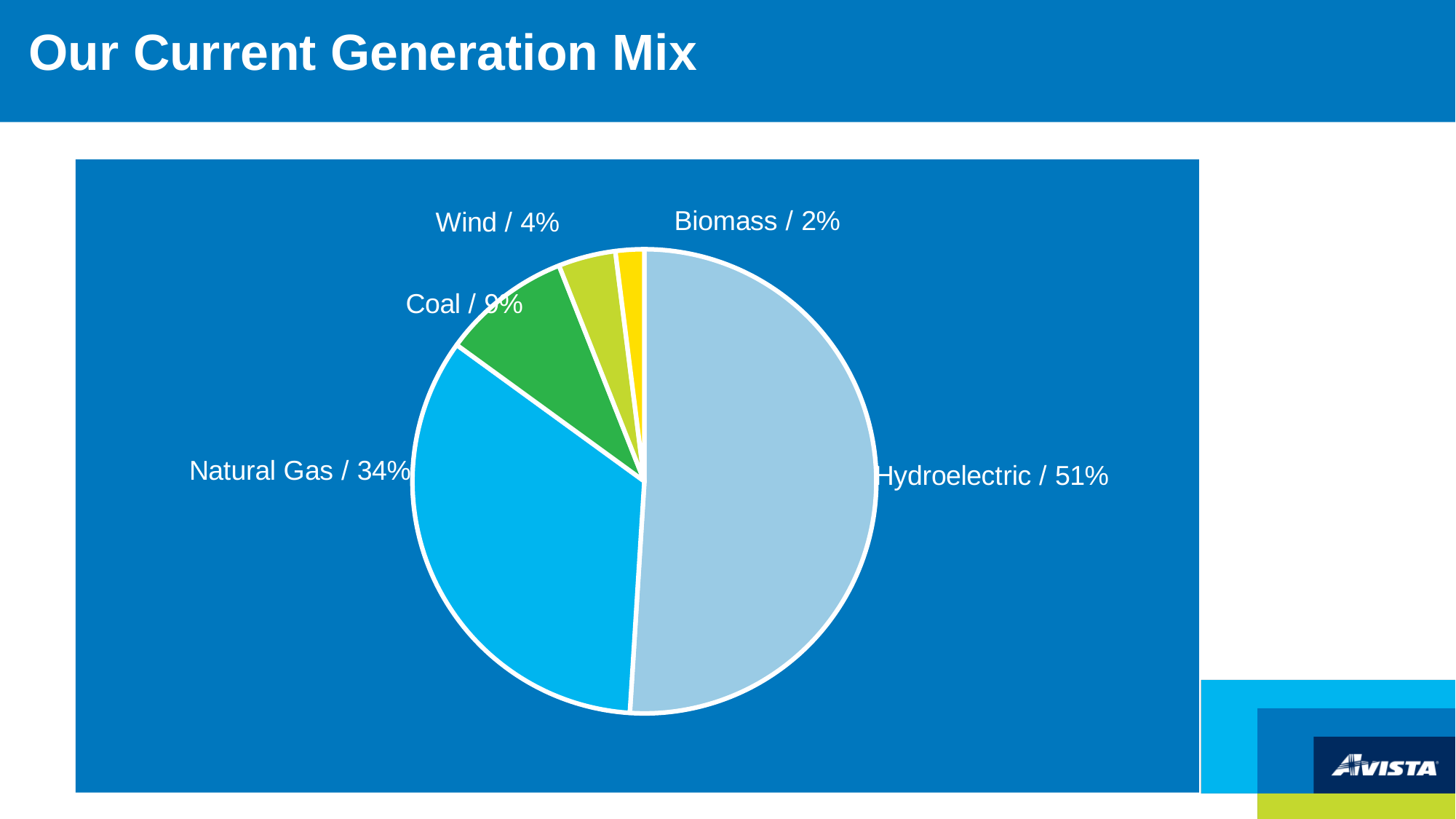
How many sources are shown in the pie chart? 5 What share of the generation mix is Wind? 4% What share of the generation mix is Hydroelectric? 51% Which source has the largest share of the generation mix? Hydroelectric Which source has the smallest share of the generation mix? Biomass What kind of chart is shown on the slide? Pie chart What share of the generation mix is Coal? 9% What is the title of the slide containing the chart? Our Current Generation Mix Which has a larger share, Coal or Wind? Coal How many percentage points larger is the Hydroelectric share than the Natural Gas share? 17 What share of the generation mix is Natural Gas? 34% What share of the generation mix is Biomass? 2%